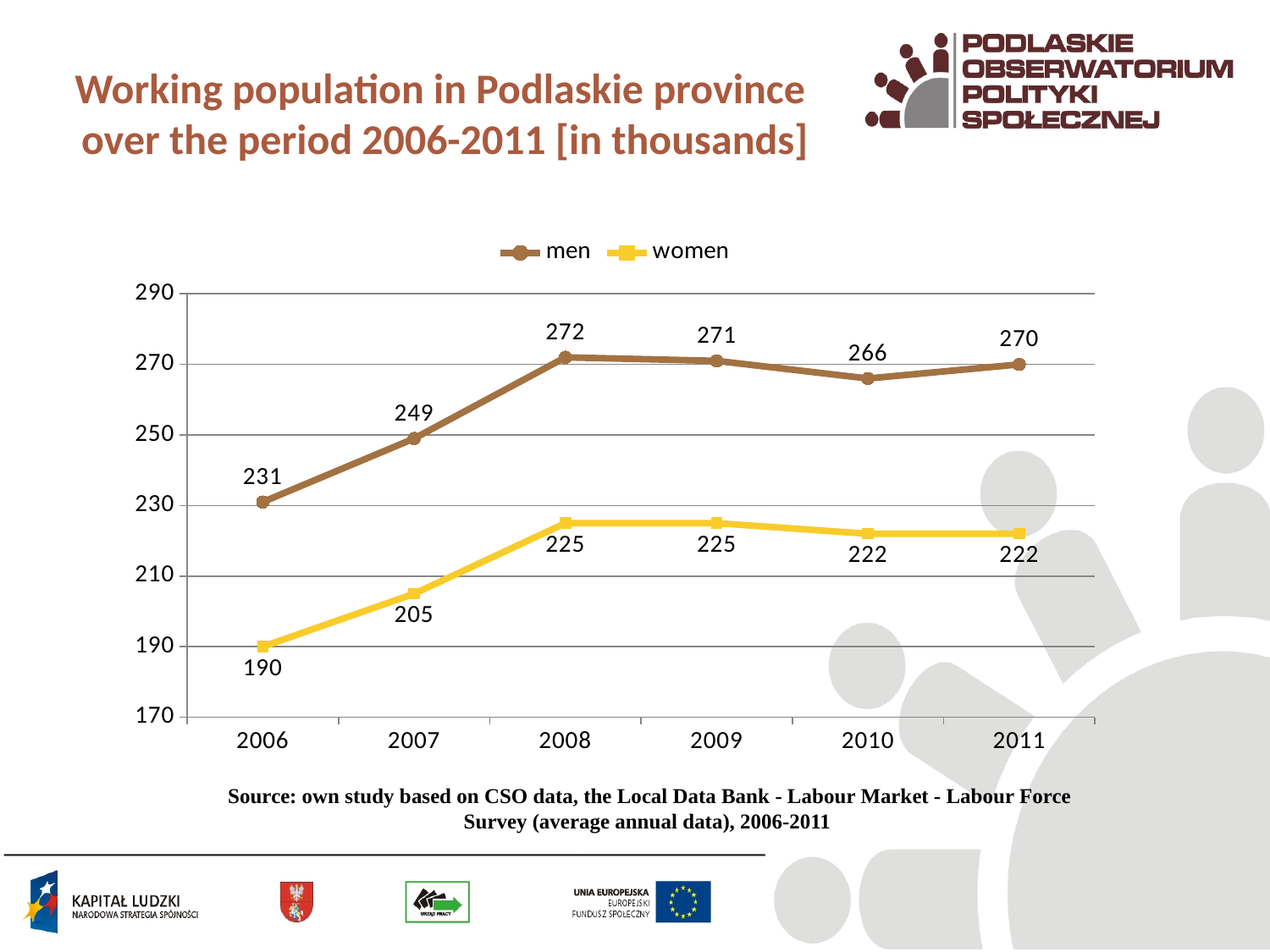
What is the difference between the men and women values in 2011? 48 How many years are plotted on the x axis? 6 How many series does the legend list? 2 In which year is the value for men highest? 2008 What is the difference between the men values in 2007 and 2006? 18 What is the value for women in 2010? 222 Which is larger, the value for men in 2009 or the value for men in 2010? men in 2009 What kind of chart is shown on the slide? line chart What is the value for women in 2006? 190 What is the value for men in 2008? 272 Does the value for women rise or fall from 2006 to 2008? rise In which year is the value for women lowest? 2006